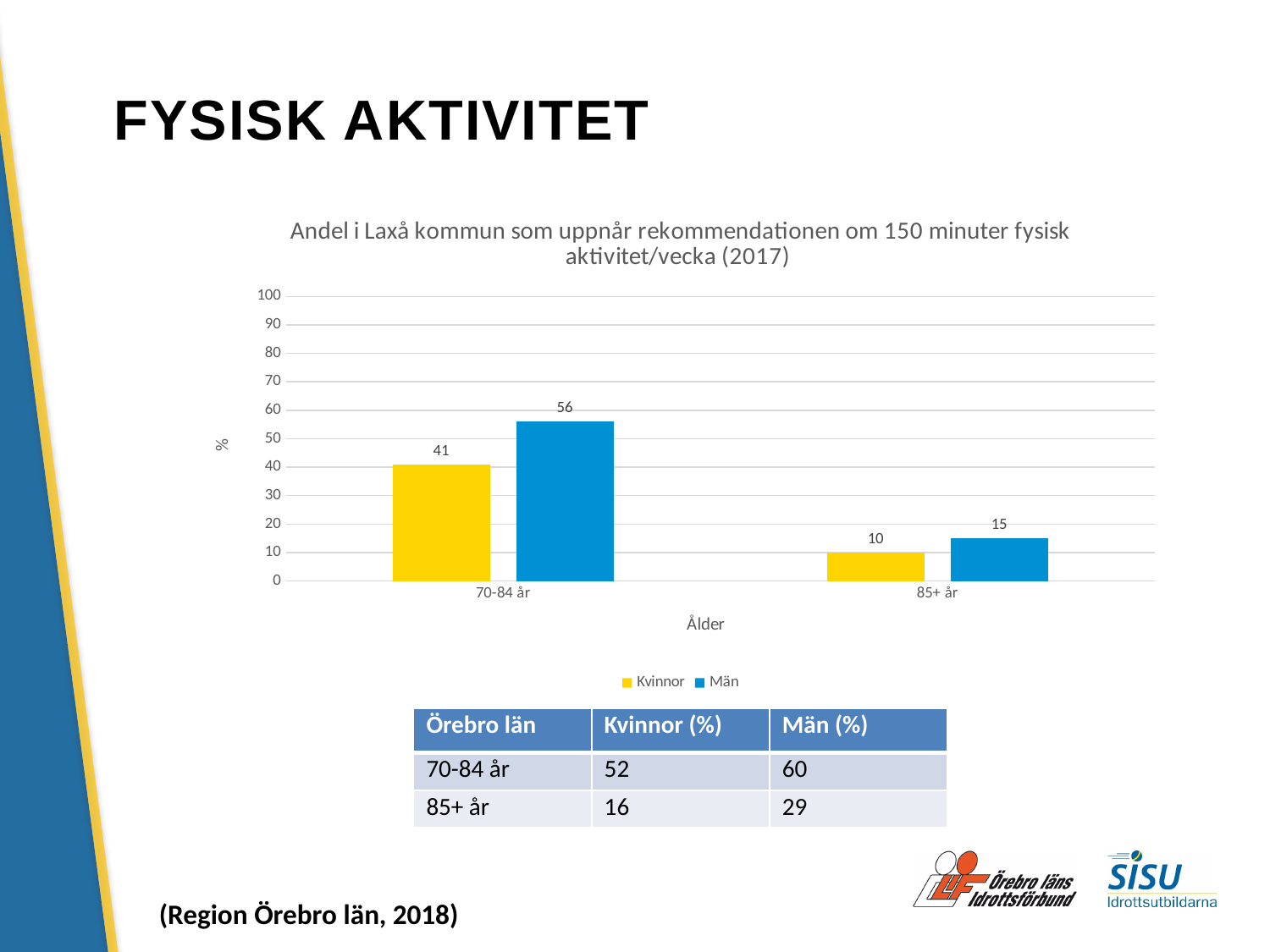
What is the value for Kvinnor in the 85+ år category? 10 Which series has the highest value in the 70-84 år category? Män Which bar has the lowest value in the chart? Kvinnor, 85+ år Which is larger, the Kvinnor value for 70-84 år or the Män value for 85+ år? Kvinnor value for 70-84 år What is the label of the x axis? Ålder What is the value for Kvinnor in the 70-84 år category? 41 What is the difference between Män and Kvinnor in the 70-84 år category? 15 What is the difference between the Män values for 70-84 år and 85+ år? 41 How many series does the legend list? 2 What kind of chart is shown on the slide? Bar chart How many age categories are shown on the x axis? 2 What is the value for Män in the 85+ år category? 15